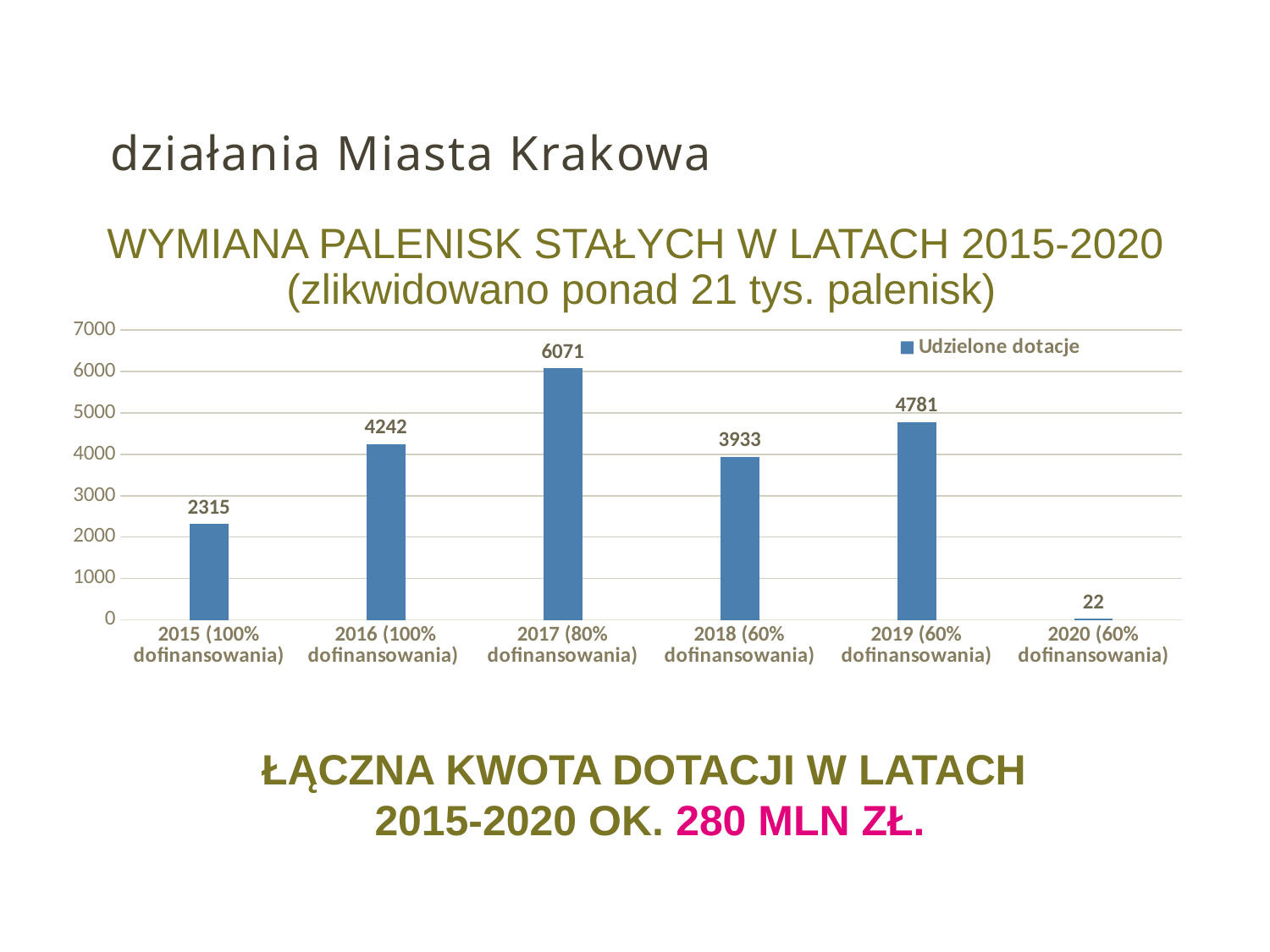
What is the difference between the values for 2017 and 2018? 2138 What is the name of the series in the legend? Udzielone dotacje How many years are shown on the x axis? 6 What is the value for 2017 (80% dofinansowania)? 6071 What is the value for 2020 (60% dofinansowania)? 22 Which is larger, the value for 2016 or the value for 2019? 2019 (60% dofinansowania) What is the value for 2015 (100% dofinansowania)? 2315 What kind of chart is shown? bar chart Which year has the highest number of Udzielone dotacje? 2017 (80% dofinansowania) Is the value for 2018 (60% dofinansowania) greater or less than 3000? greater How many series does the legend list? 1 Which year has the lowest number of Udzielone dotacje? 2020 (60% dofinansowania)